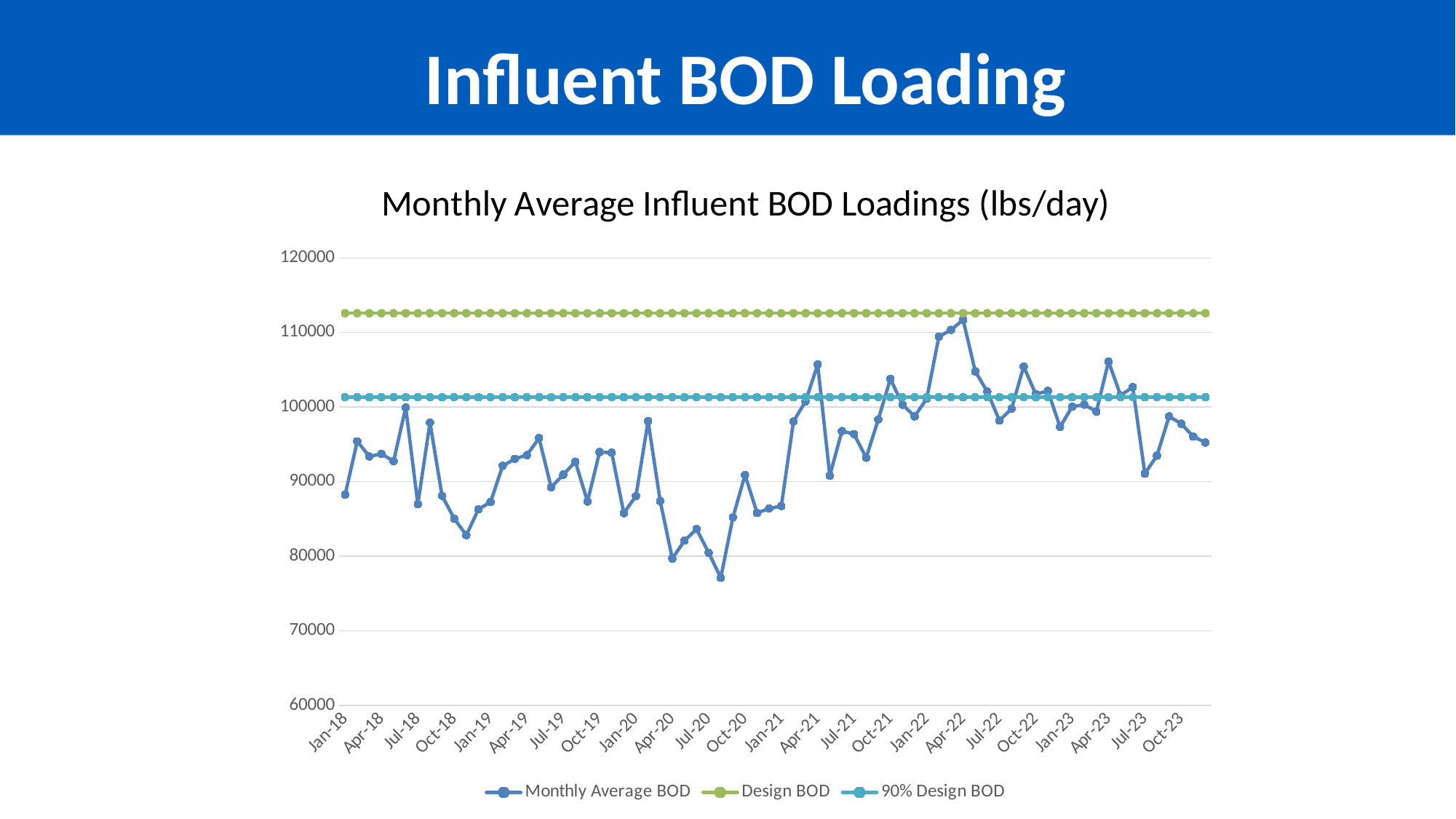
Does the Design BOD series rise, fall, or stay flat across the x axis? Stays flat What kind of chart is shown on the slide? Line chart Which is higher, the Monthly Average BOD for Jan-18 or for Jan-22? Jan-22 Which series is shown in green in the legend? Design BOD Is the 90% Design BOD value greater or less than 110000? less What is the title of the chart? Monthly Average Influent BOD Loadings (lbs/day) Is the Design BOD value greater or less than 110000? greater Is the Monthly Average BOD value for Jul-20 greater or less than 90000? less Which series has the higher value, Design BOD or 90% Design BOD? Design BOD How many series does the legend list? 3